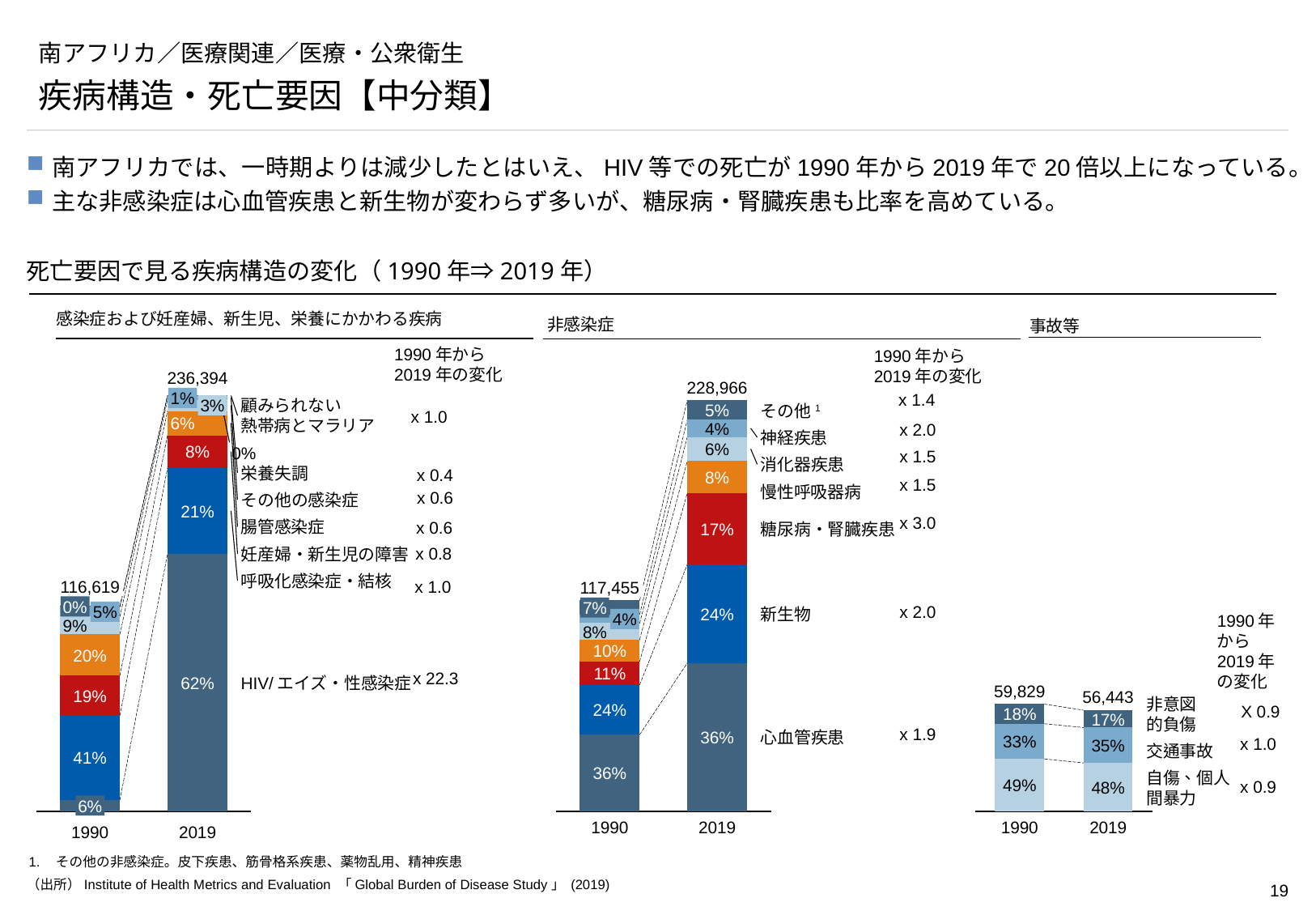
「非感染症」のグラフで、2019年の糖尿病・腎臓疾患の割合は何%ですか？ 17% 「非感染症」のグラフで、2019年の心血管疾患の割合は何%ですか？ 36% このスライドのグラフはどの種類のグラフですか？ 積み上げ棒グラフ 「非感染症」のグラフで、新生物の1990年から2019年の変化は何倍と示されていますか？ x 2.0 「事故等」のグラフで、交通事故の割合は1990年と2019年のどちらが大きいですか？ 2019年 「感染症および妊産婦、新生児、栄養にかかわる疾病」のグラフで、2019年の合計値はいくつですか？ 236,394 「感染症および妊産婦、新生児、栄養にかかわる疾病」のグラフで、2019年のHIV/エイズ・性感染症の割合は何%ですか？ 62% 「非感染症」のグラフで、2019年の合計値と1990年の合計値の差はいくつですか？ 111,511 「非感染症」のグラフで、2019年に最も割合が大きい項目はどれですか？ 心血管疾患 「感染症および妊産婦、新生児、栄養にかかわる疾病」のグラフで、HIV/エイズ・性感染症の1990年から2019年の変化は何倍と示されていますか？ x 22.3 「事故等」のグラフで、1990年の合計値はいくつですか？ 59,829 「事故等」のグラフで、2019年の自傷、個人間暴力の割合は何%ですか？ 48%